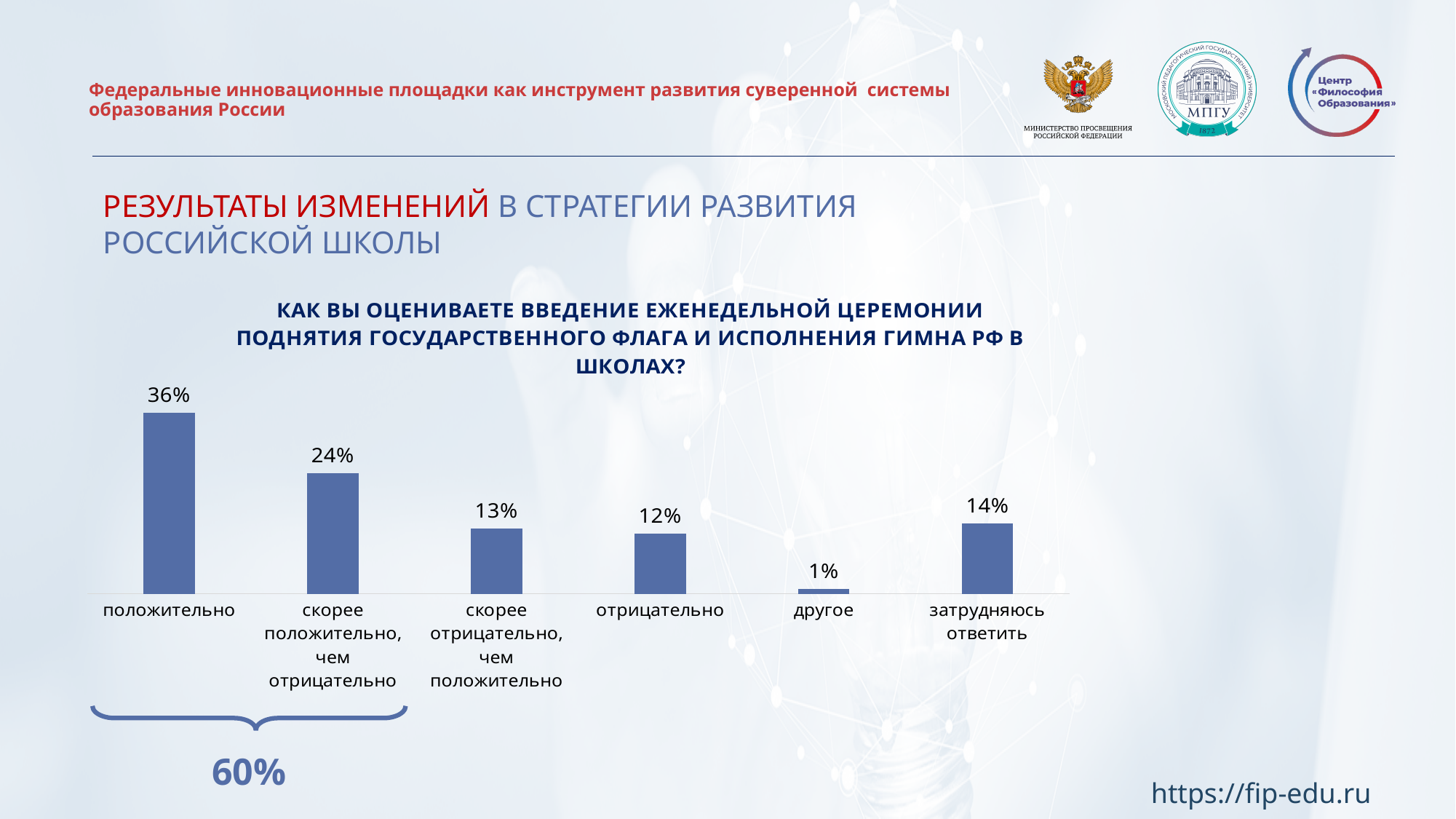
What is the value for "затрудняюсь ответить"? 14% Which category has the highest value? положительно What is the difference between "положительно" and "скорее положительно, чем отрицательно"? 12% What kind of chart is shown on the slide? bar chart What is the value for "положительно"? 36% How many categories are shown in the chart? 6 What is the combined value of "положительно" and "скорее положительно, чем отрицательно" as shown by the bracket under the chart? 60% Which category has the lowest value? другое What is the value for "скорее положительно, чем отрицательно"? 24% Which is larger, "скорее отрицательно, чем положительно" or "отрицательно"? скорее отрицательно, чем положительно What is the title of the chart? КАК ВЫ ОЦЕНИВАЕТЕ ВВЕДЕНИЕ ЕЖЕНЕДЕЛЬНОЙ ЦЕРЕМОНИИ ПОДНЯТИЯ ГОСУДАРСТВЕННОГО ФЛАГА И ИСПОЛНЕНИЯ ГИМНА РФ В ШКОЛАХ? What is the value for "другое"? 1%